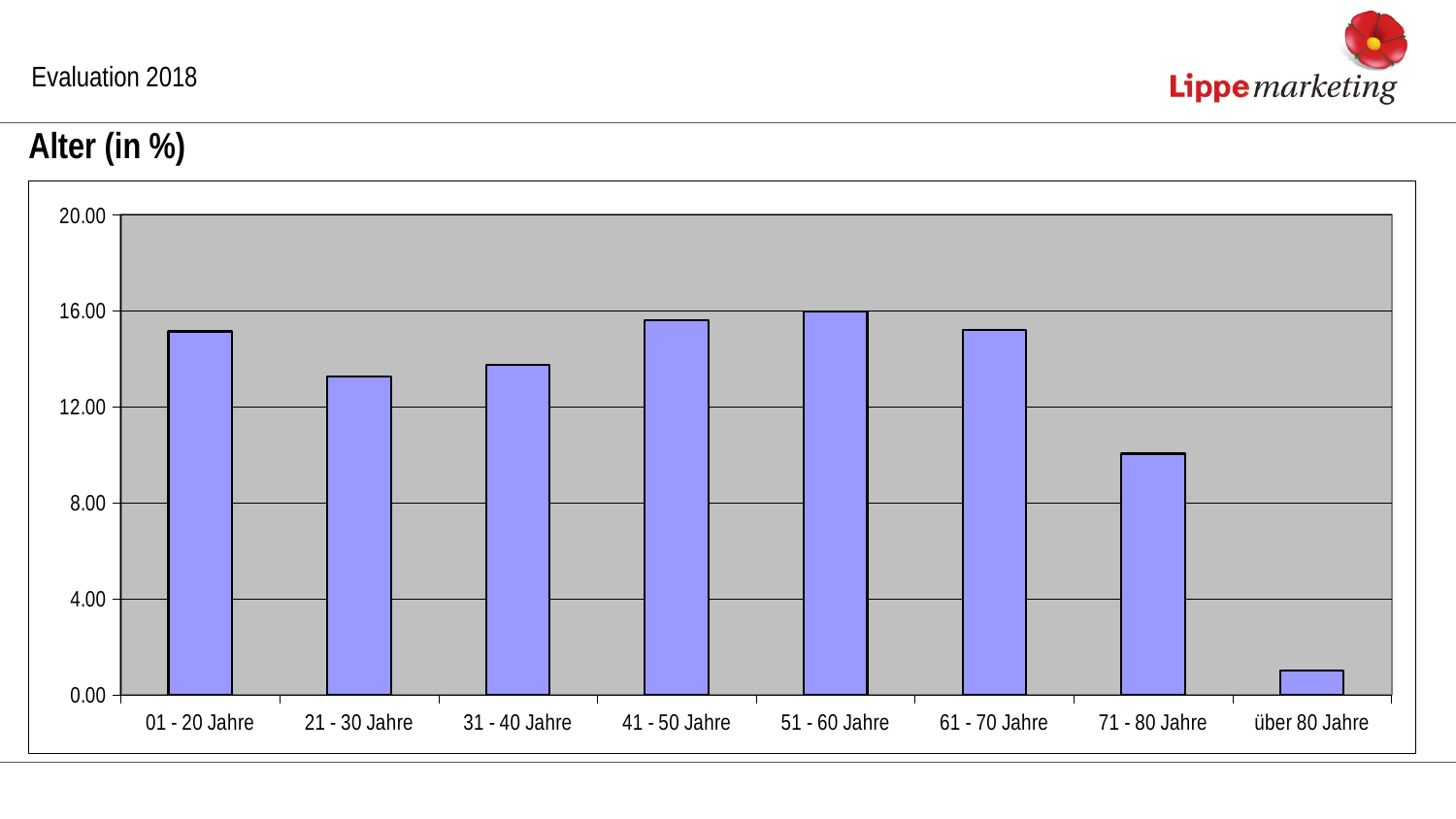
Is the value for 21 - 30 Jahre greater or less than 12.00? greater Is the value for über 80 Jahre greater or less than 4.00? less How many age categories are shown on the x axis? 8 Which is larger, the value for 71 - 80 Jahre or the value for über 80 Jahre? 71 - 80 Jahre Which age category has the lowest value? über 80 Jahre Which is larger, the value for 01 - 20 Jahre or the value for 21 - 30 Jahre? 01 - 20 Jahre What is the title of the chart? Alter (in %) What kind of chart is shown on the slide? bar chart Do the values rise or fall from 61 - 70 Jahre to über 80 Jahre? fall Is the value for 71 - 80 Jahre greater or less than 12.00? less